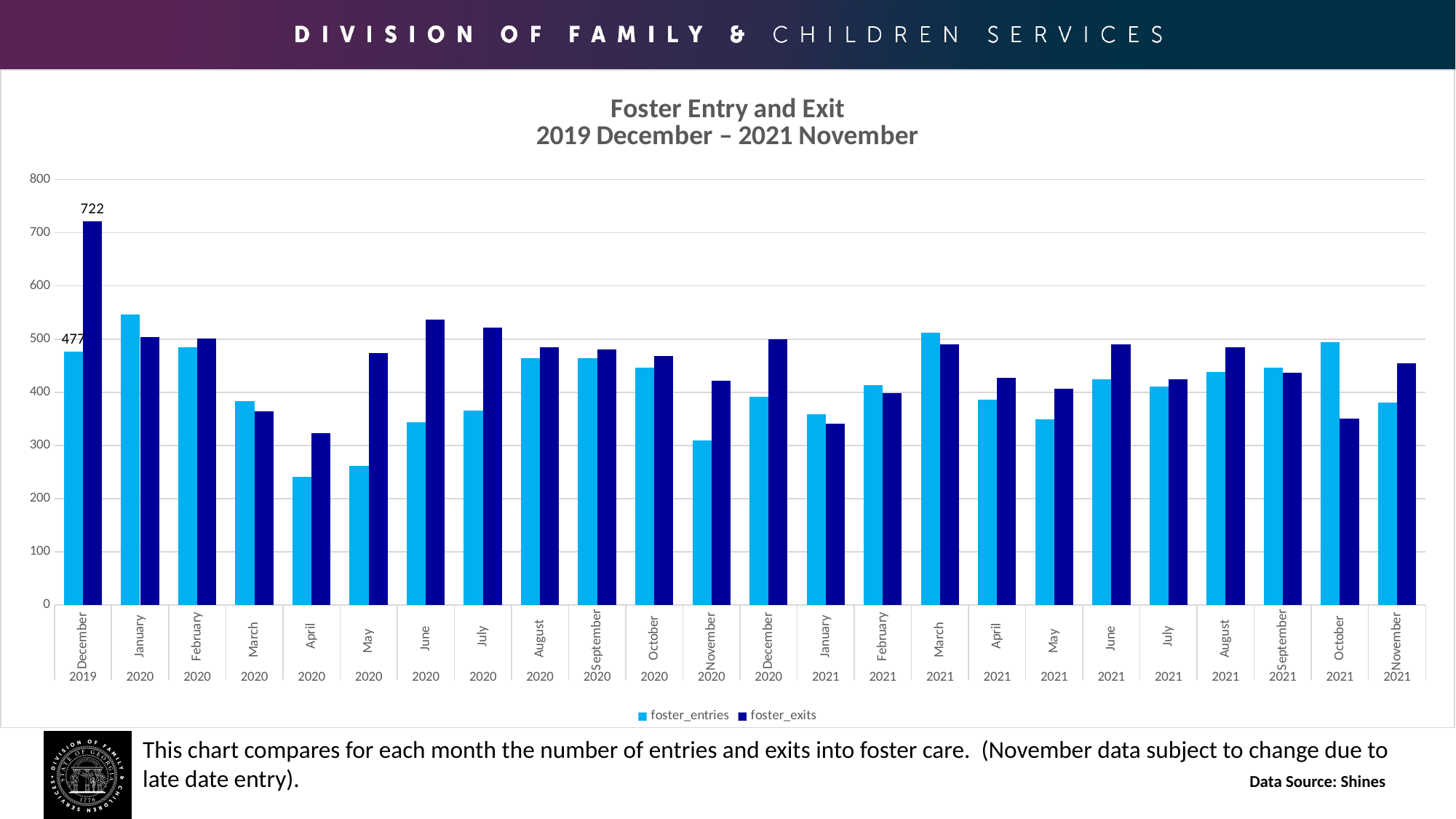
Is the value of foster_entries for January 2020 greater or less than 500? greater What is the value of foster_exits for December 2019? 722 What kind of chart is shown on the slide? Bar chart In which month is the foster_exits value highest? December 2019 In which month is the foster_entries value lowest? April 2020 How many series does the legend list? 2 What is the difference between foster_exits and foster_entries in December 2019? 245 In October 2021, which is larger: foster_entries or foster_exits? foster_entries What is the value of foster_entries for December 2019? 477 In April 2020, which is larger: foster_entries or foster_exits? foster_exits How many months are shown on the x axis? 24 Is the value of foster_exits for October 2021 greater or less than 400? less